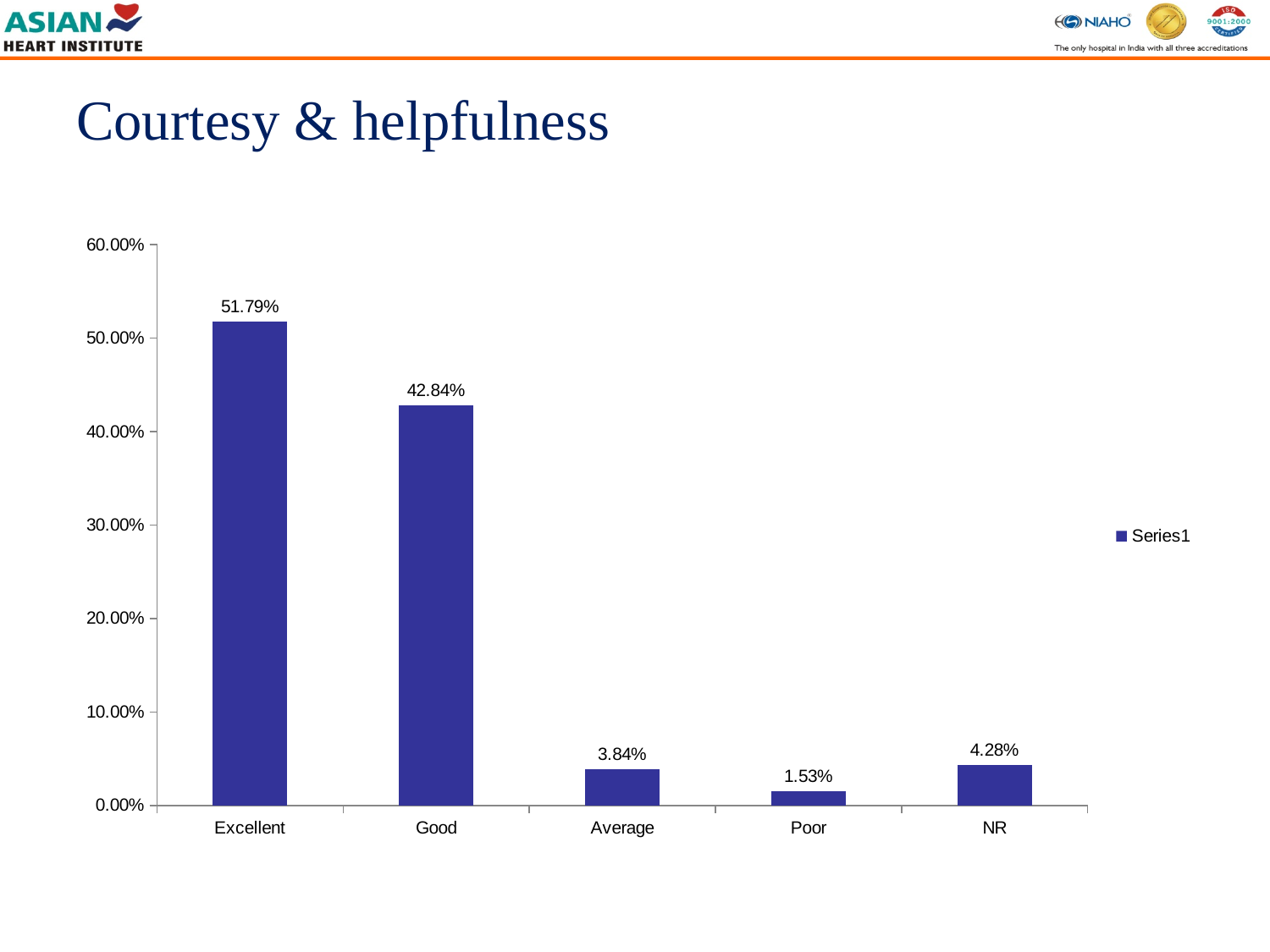
What is the difference between the values for Excellent and Good? 8.95% What is the value for NR? 4.28% Is the value for Good greater or less than 40.00%? greater What kind of chart is shown on the slide? bar chart Which category has the highest value? Excellent What is the value for Excellent? 51.79% How many categories are shown on the x axis? 5 Which category has the lowest value? Poor Which is larger, the value for Average or the value for NR? NR What is the value for Good? 42.84% What is the value for Poor? 1.53% What is the title of the slide? Courtesy & helpfulness